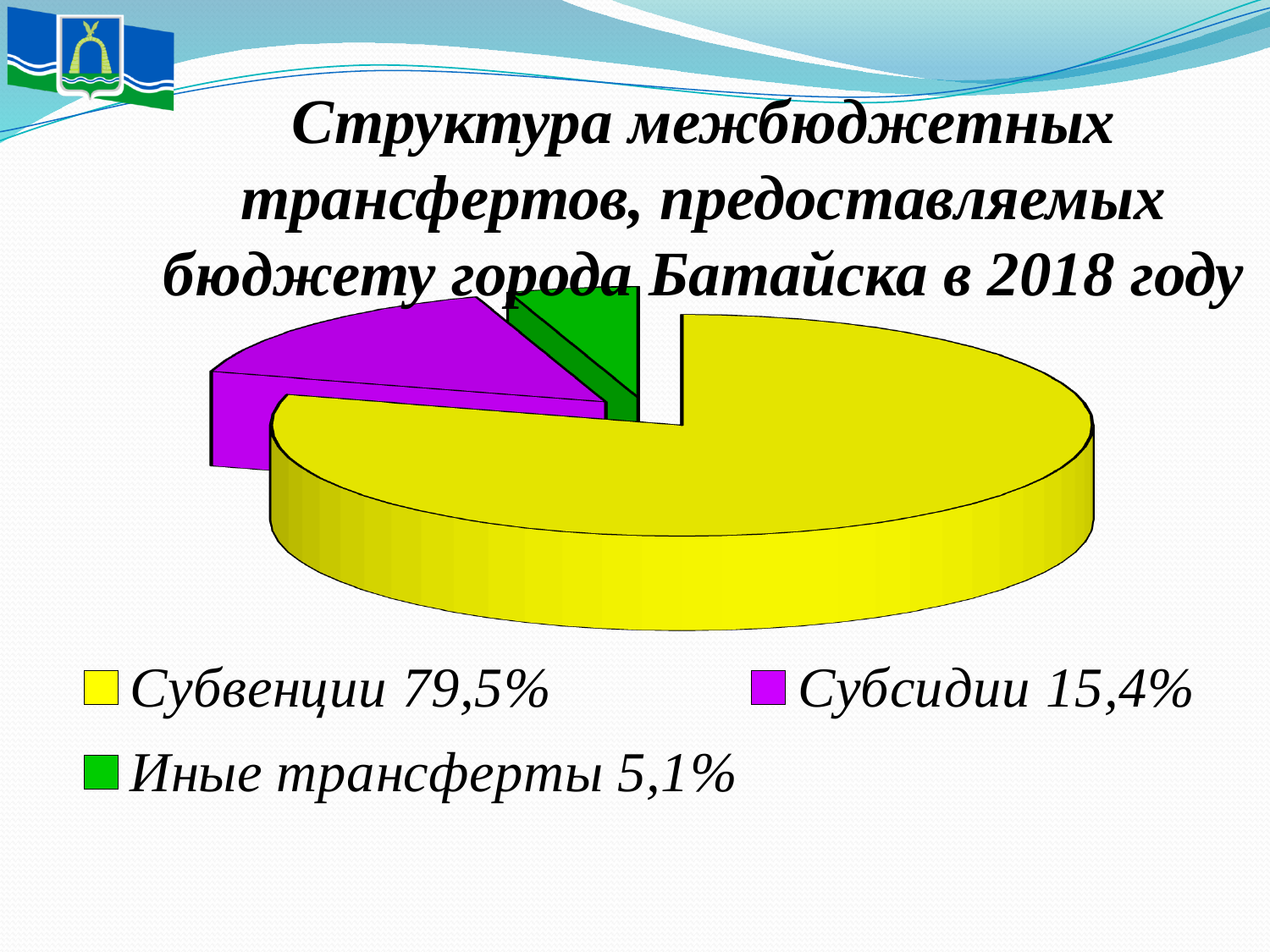
What colour is the slice for Иные трансферты? green What kind of chart is shown on the slide? pie chart Which category has the largest share of the pie? Субвенции What share of the pie does Иные трансферты have? 5,1% What share of the pie does Субсидии have? 15,4% What is the difference between the shares of Субсидии and Иные трансферты? 10,3% What colour is the slice for Субсидии? purple What share of the pie does Субвенции have? 79,5% How many categories does the pie chart show? 3 What is the difference between the shares of Субвенции and Субсидии? 64,1% Which is larger, the share for Субсидии or the share for Иные трансферты? Субсидии Which category has the smallest share of the pie? Иные трансферты